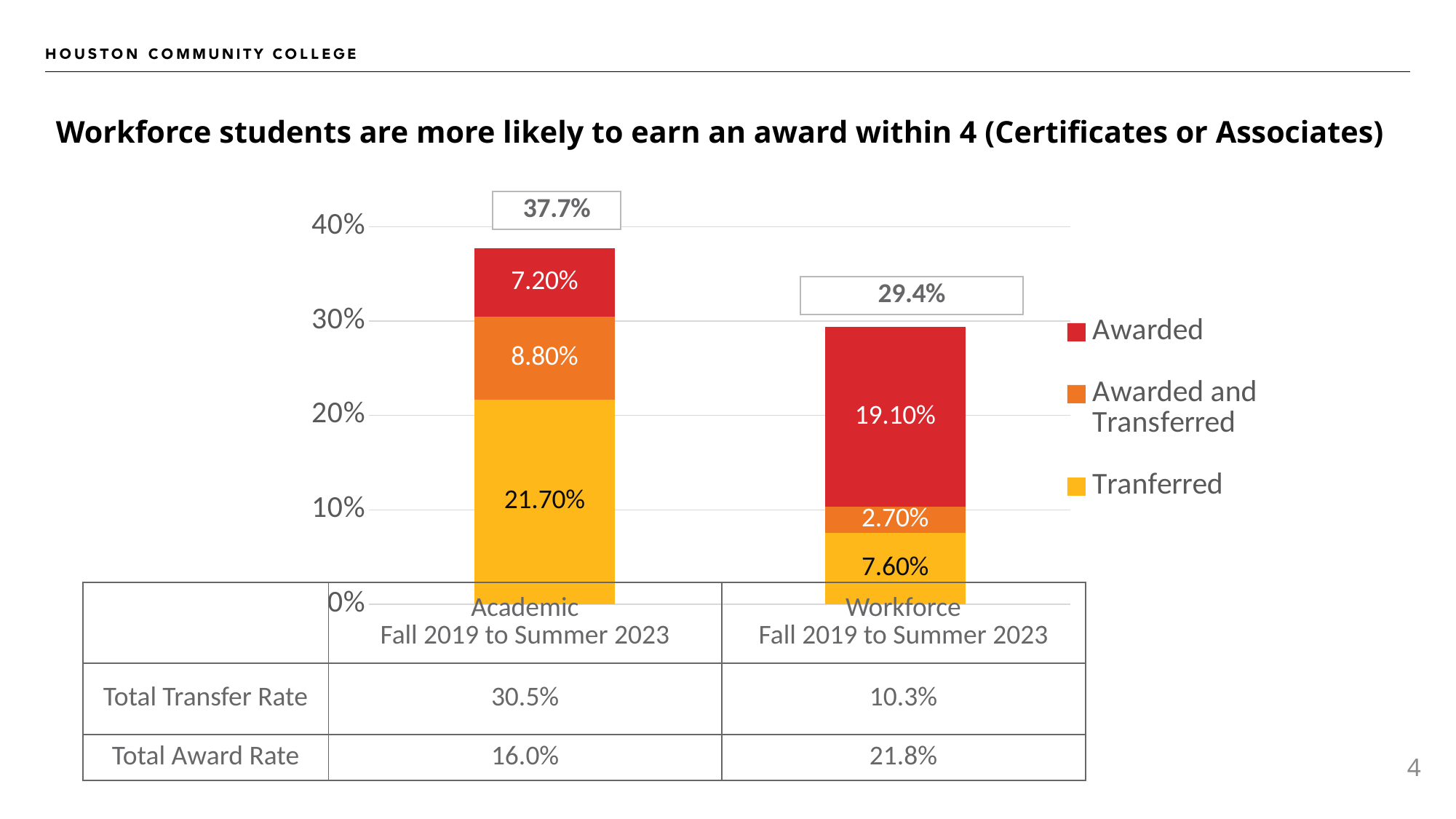
Which colour represents the Awarded series in the legend? Red What is the Awarded value for the Academic group? 7.20% What is the Awarded value for the Workforce group? 19.10% What kind of chart is shown on the slide? Stacked bar chart Which group has the higher Awarded value, Academic or Workforce? Workforce How many series does the legend list? 3 What is the Awarded and Transferred value for the Workforce group? 2.70% What is the Transferred value for the Workforce group? 7.60% How many categories are shown on the x axis? 2 What is the total of the stacked bar for the Academic group? 37.7% What is the total of the stacked bar for the Workforce group? 29.4% What is the difference between the Transferred values for Academic and Workforce? 14.10%